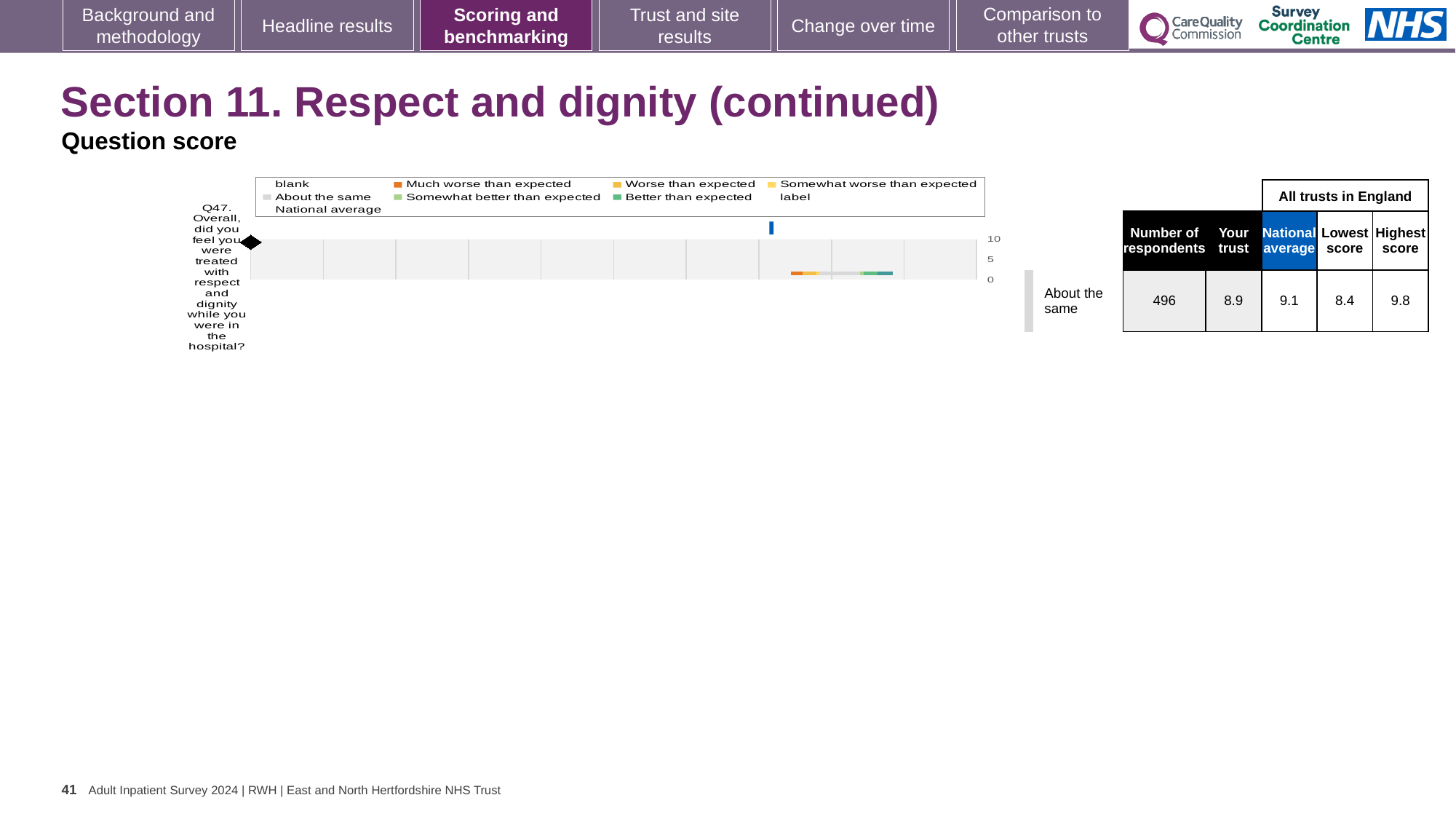
What is the 'Your trust' score for Q47 shown in the table beside the chart? 8.9 What is the difference between the national average and the trust's score for Q47? 0.2 Which benchmarking category is the trust's Q47 score placed in, according to the label next to the chart? About the same What is the highest tick value shown on the chart's axis? 10 How many respondents answered Q47? 496 What is the national average score for Q47 shown in the table beside the chart? 9.1 What is the highest score among all trusts in England for Q47? 9.8 What question is the chart on this slide about? Q47. Overall, did you feel you were treated with respect and dignity while you were in the hospital? What is the difference between the highest and lowest scores among all trusts in England for Q47? 1.4 Which is larger for Q47, the trust's score or the national average? National average What is the lowest score among all trusts in England for Q47? 8.4 How many entries does the chart's legend list? 9